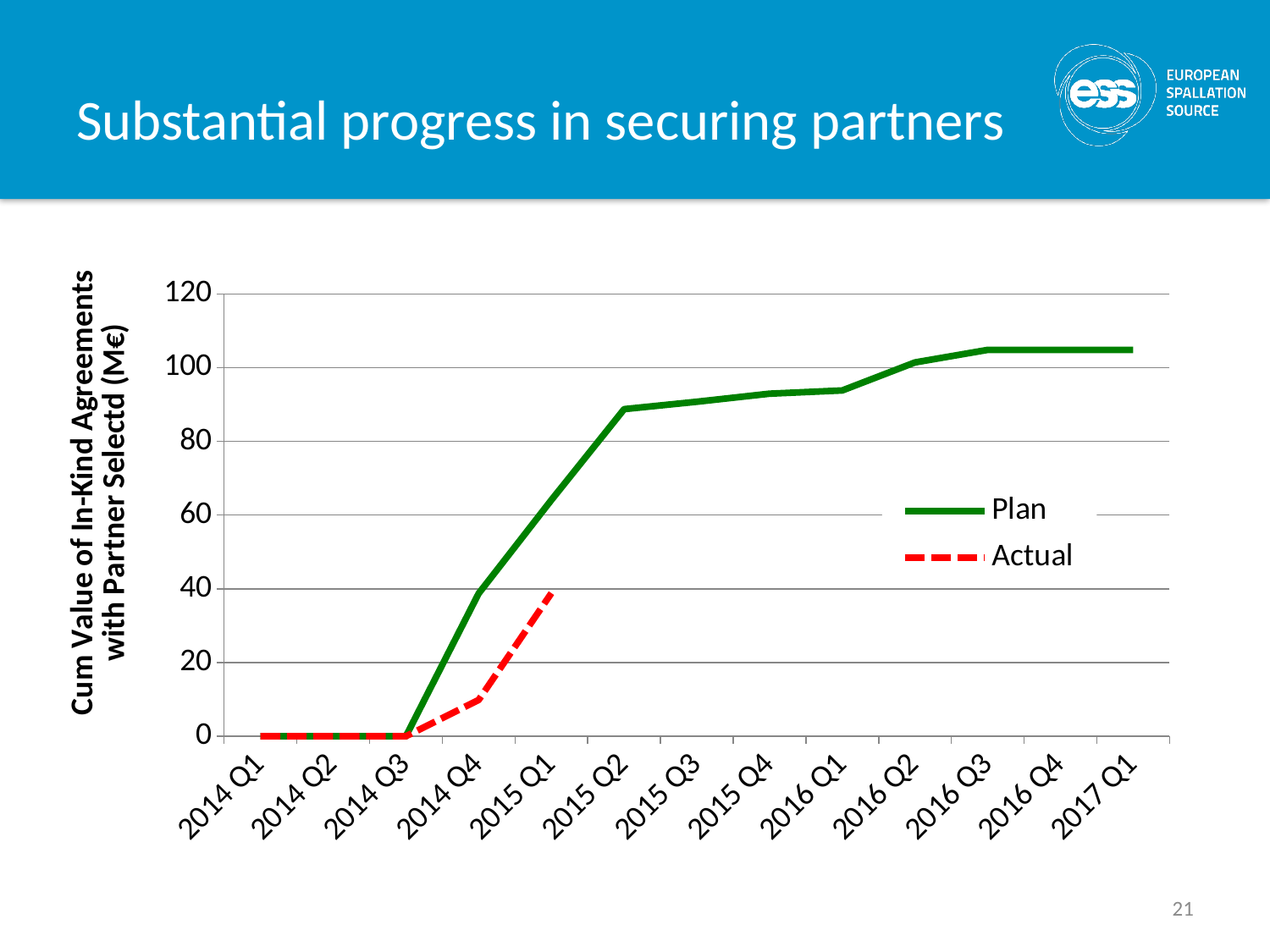
What is the y-axis title of the chart? Cum Value of In-Kind Agreements with Partner Selectd (M€) Is the Plan value at 2017 Q1 greater or less than 100? greater How many quarters are shown along the x axis? 13 What are the two series named in the legend? Plan and Actual At 2015 Q1, which series has the larger value, Plan or Actual? Plan What kind of chart is shown on the slide? line chart What is the Plan value at 2014 Q1? 0 How many series does the legend list? 2 What is the Actual value at 2014 Q3? 0 Does the Plan series rise or fall from 2014 Q3 to 2015 Q2? rise Is the Plan value at 2015 Q2 greater or less than 80? greater